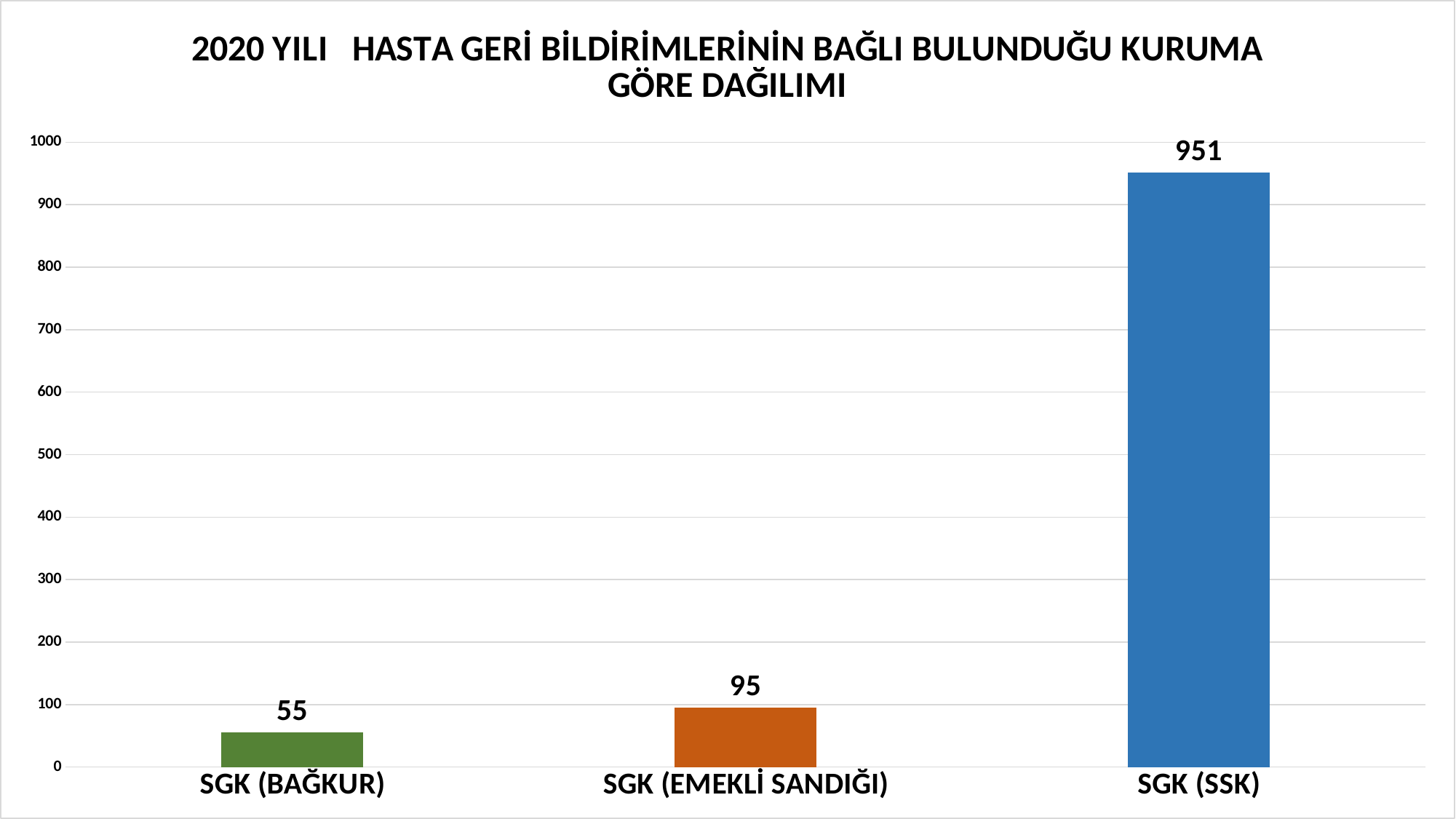
What is the difference between the values for SGK (EMEKLİ SANDIĞI) and SGK (BAĞKUR)? 40 What kind of chart is shown on the slide? Bar chart What is the value for SGK (EMEKLİ SANDIĞI)? 95 What is the title of the chart? 2020 YILI HASTA GERİ BİLDİRİMLERİNİN BAĞLI BULUNDUĞU KURUMA GÖRE DAĞILIMI Which category has the highest value? SGK (SSK) Which category has the lowest value? SGK (BAĞKUR) Which is larger, the value for SGK (BAĞKUR) or SGK (EMEKLİ SANDIĞI)? SGK (EMEKLİ SANDIĞI) What is the value for SGK (BAĞKUR)? 55 What is the value for SGK (SSK)? 951 Is the value for SGK (SSK) greater or less than 900? greater How many categories are shown on the chart? 3 What is the difference between the values for SGK (SSK) and SGK (EMEKLİ SANDIĞI)? 856